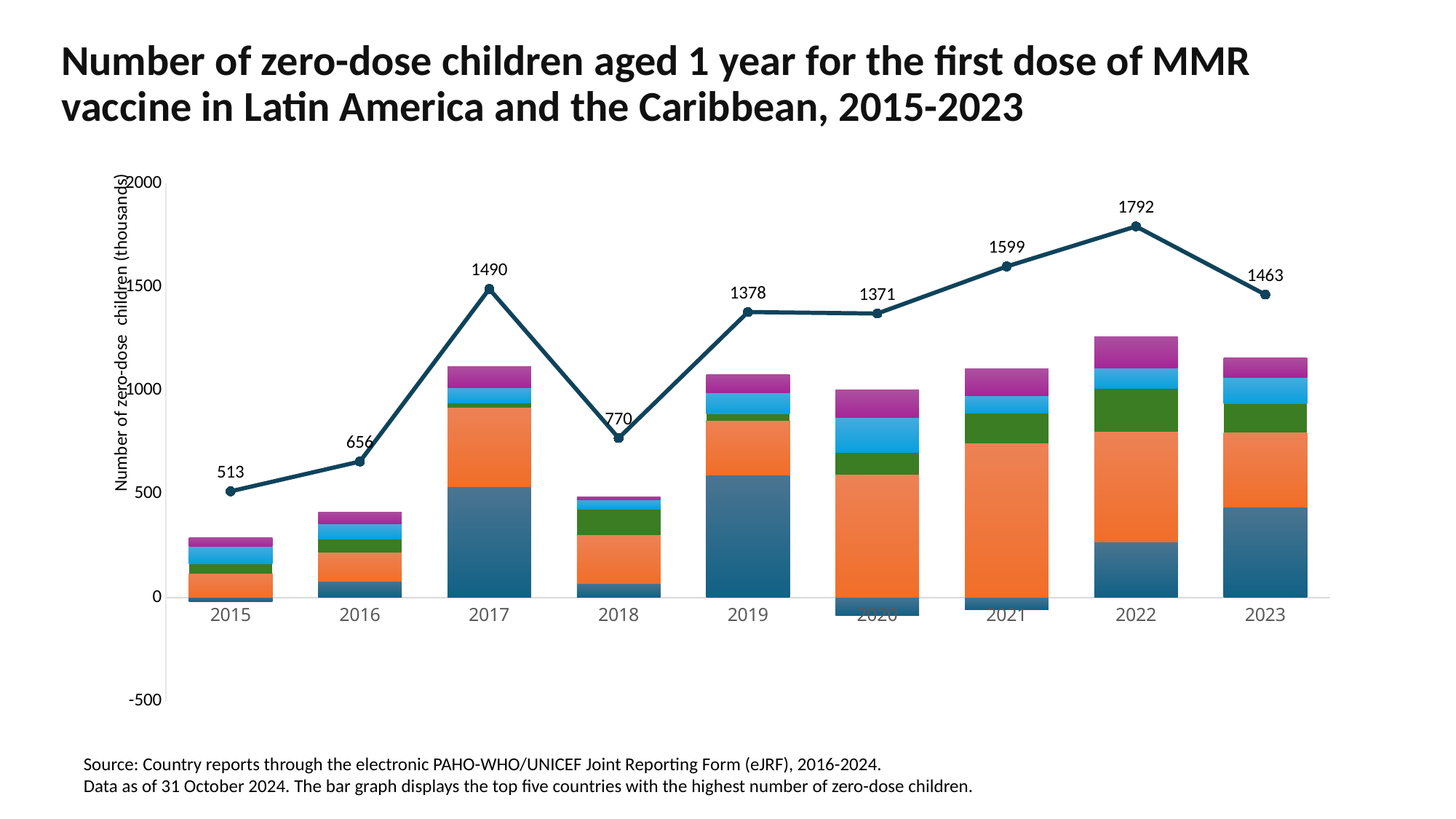
In which year does the line have its lowest value? 2015 What is the label of the vertical axis? Number of zero-dose children (thousands) What is the difference between the line values for 2017 and 2018? 720 What is the value shown on the line for 2015? 513 What kind of chart is shown on the slide? Combined stacked bar and line chart Is the top of the stacked bar for 2022 greater or less than 1000? greater How many years are shown on the x axis? 9 What is the value shown on the line for 2017? 1490 In which year does the line reach its highest value? 2022 Which year has the larger line value, 2019 or 2020? 2019 What is the value shown on the line for 2022? 1792 What is the difference between the line values for 2022 and 2021? 193